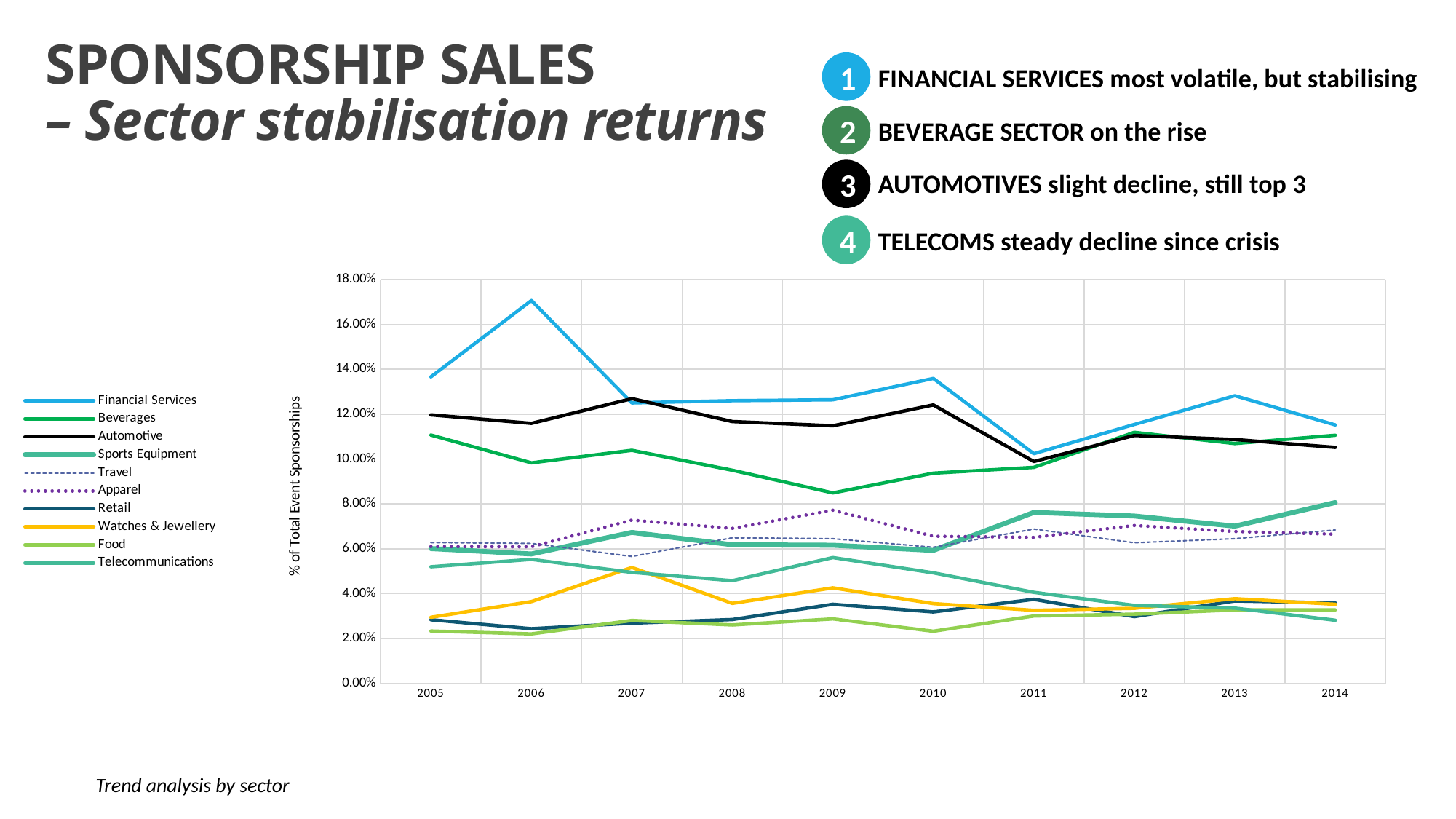
Does the Telecommunications line rise or fall from 2009 to 2014? fall What kind of chart is shown on the slide? line chart Is the value for Beverages in 2009 greater or less than 10.00%? less Which series has the highest value in 2006? Financial Services In 2014, which is larger: Sports Equipment or Telecommunications? Sports Equipment How many years are plotted along the x axis of the chart? 10 Is the value for Automotive in 2011 greater or less than 12.00%? less Which series has the lowest value in 2005? Food Which legend entry is drawn as a dotted purple line? Apparel Is the value for Financial Services in 2006 greater or less than 16.00%? greater How many series does the chart's legend list? 10 What is the title of the chart's y axis? % of Total Event Sponsorships